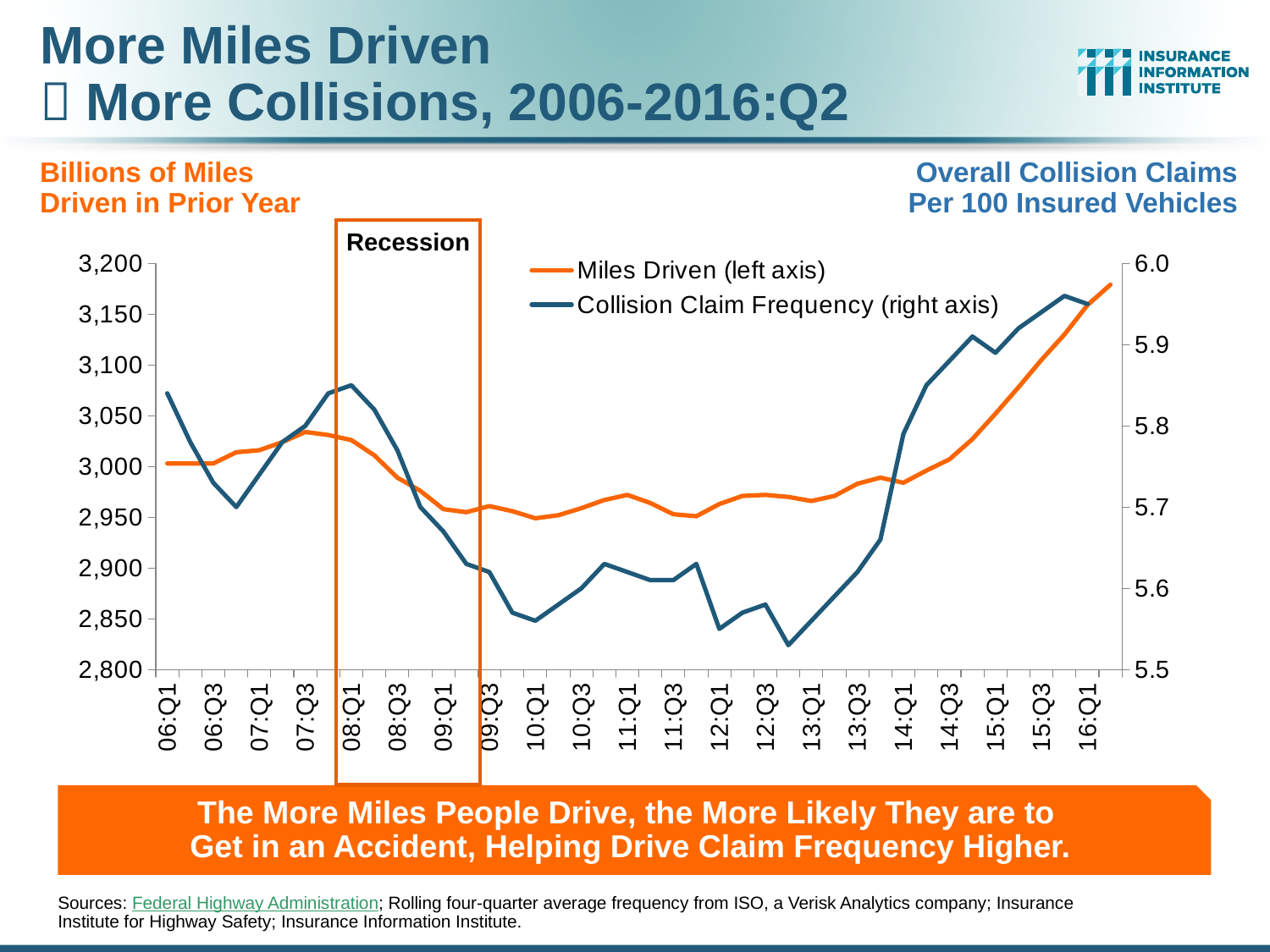
Is the value for Miles Driven at 10:Q1 greater or less than 3,000? less Is the value for Collision Claim Frequency at 12:Q3 greater or less than 5.6? less What kind of chart is shown on the slide? line chart Which series is plotted against the right axis? Collision Claim Frequency Does Miles Driven rise or fall from 13:Q1 to 16:Q1? rise Which is larger, Collision Claim Frequency at 08:Q1 or at 12:Q3? 08:Q1 Is the value for Collision Claim Frequency at 16:Q1 greater or less than 5.9? greater At which quarter is Collision Claim Frequency at its lowest? 12:Q4 At which quarter is Miles Driven at its highest? 16:Q2 What label is shown on the highlighted box over 2008-2009? Recession How many series does the legend list? 2